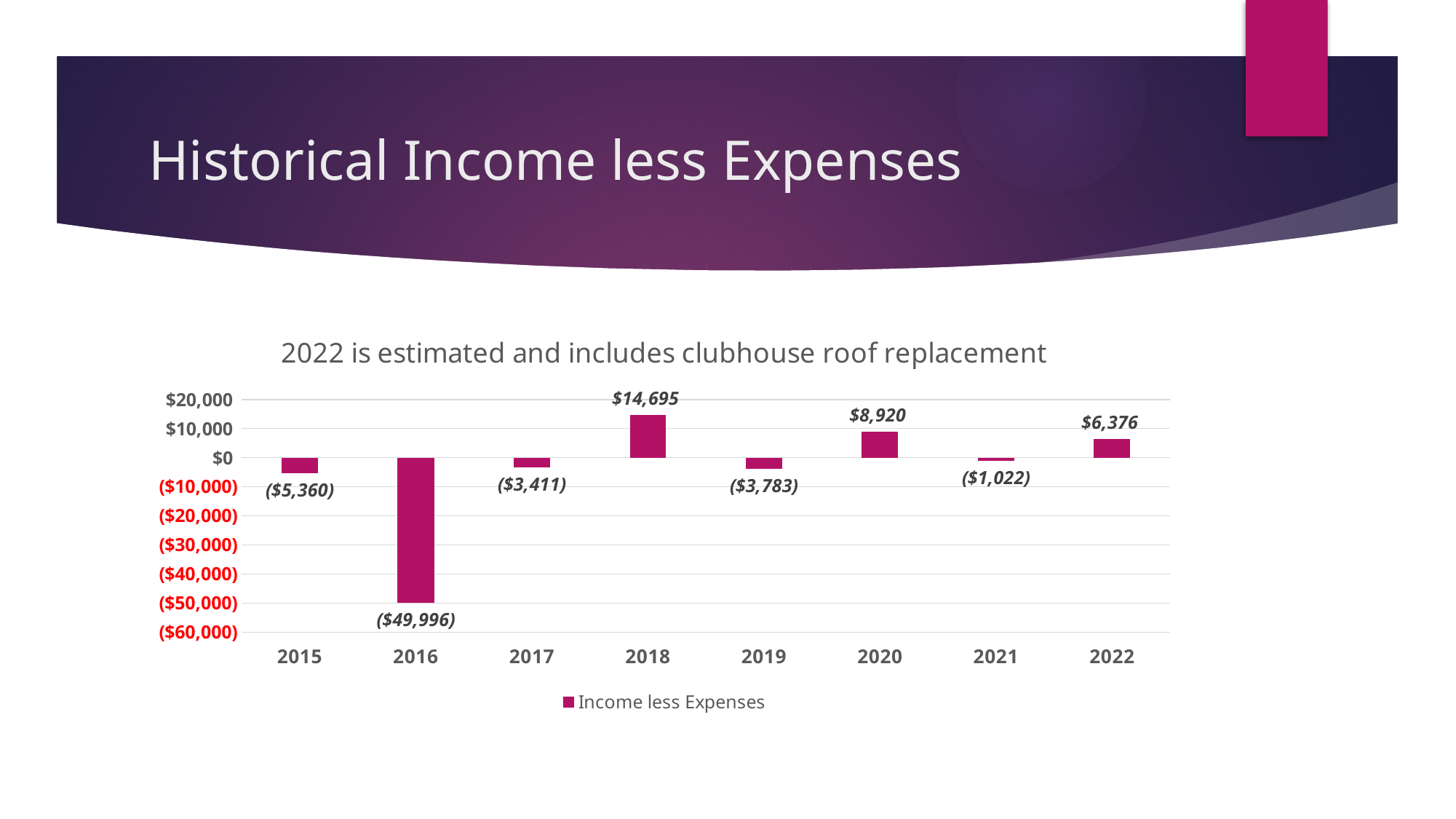
What is the value for 2018? $14,695 What kind of chart is shown? bar chart Which year has the highest Income less Expenses? 2018 Which year has the lowest Income less Expenses? 2016 What is the chart's title? 2022 is estimated and includes clubhouse roof replacement What is the value for 2021? ($1,022) What is the value for 2016? ($49,996) Is the value for 2016 greater or less than ($40,000)? less What is the difference between the values for 2018 and 2020? $5,775 Which is larger, the value for 2020 or the value for 2022? 2020 How many years are shown on the x axis? 8 What is the value for 2022? $6,376